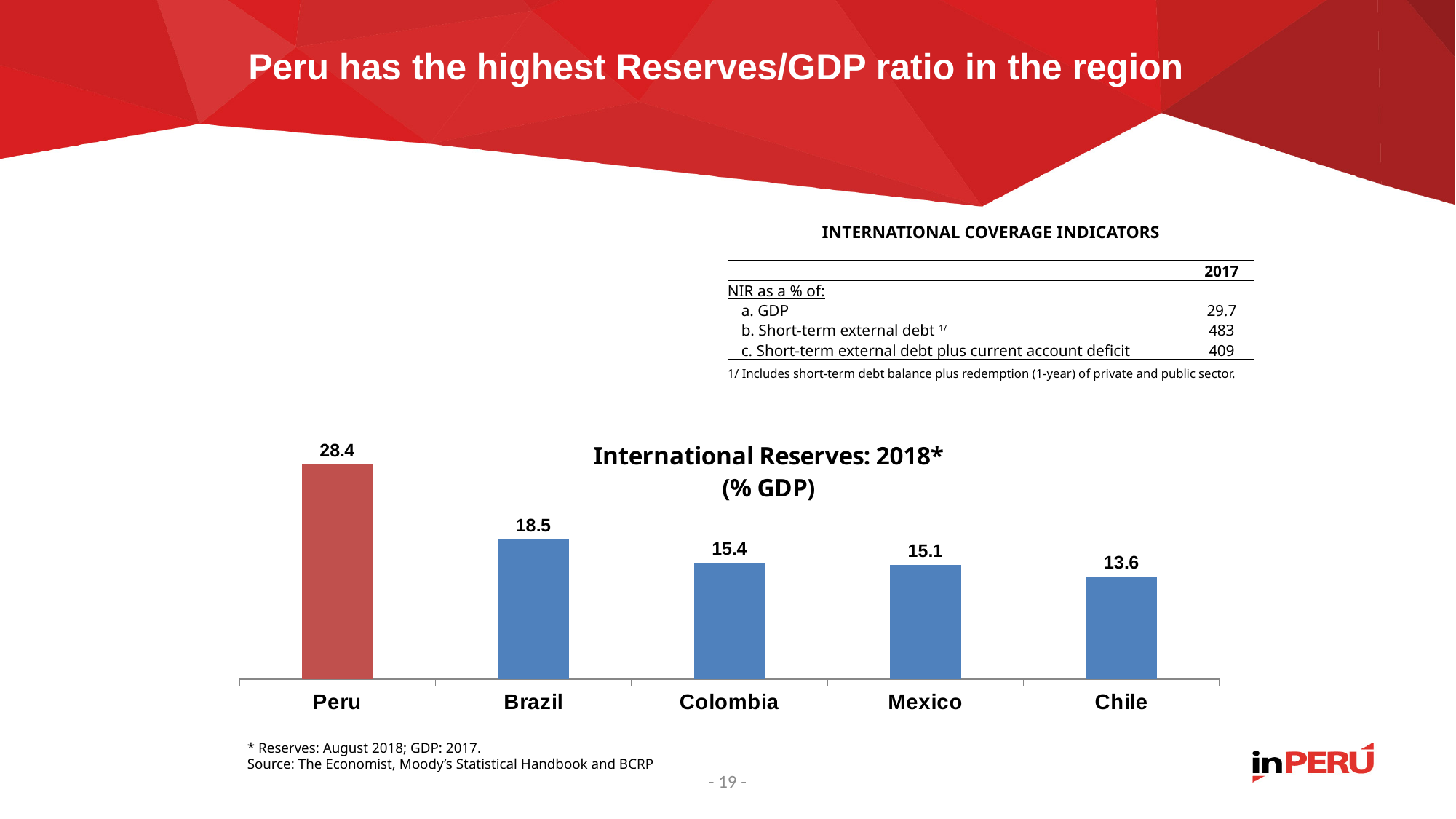
Which country has the highest International Reserves (% GDP) in the chart? Peru What is the difference between the values for Peru and Brazil in the International Reserves chart? 9.9 Which bar in the International Reserves chart is coloured red rather than blue? Peru What is the value for Brazil in the International Reserves: 2018 chart? 18.5 Do the values in the International Reserves chart rise or fall from Peru to Chile along the x axis? Fall What is the difference between the values for Colombia and Chile in the International Reserves chart? 1.8 Which has a larger value in the International Reserves chart, Brazil or Mexico? Brazil How many countries are shown in the International Reserves: 2018 chart? 5 What is the value for Peru in the International Reserves: 2018 chart? 28.4 What kind of chart is the International Reserves: 2018 chart? Bar chart What is the value for Chile in the International Reserves: 2018 chart? 13.6 Which country has the lowest International Reserves (% GDP) in the chart? Chile